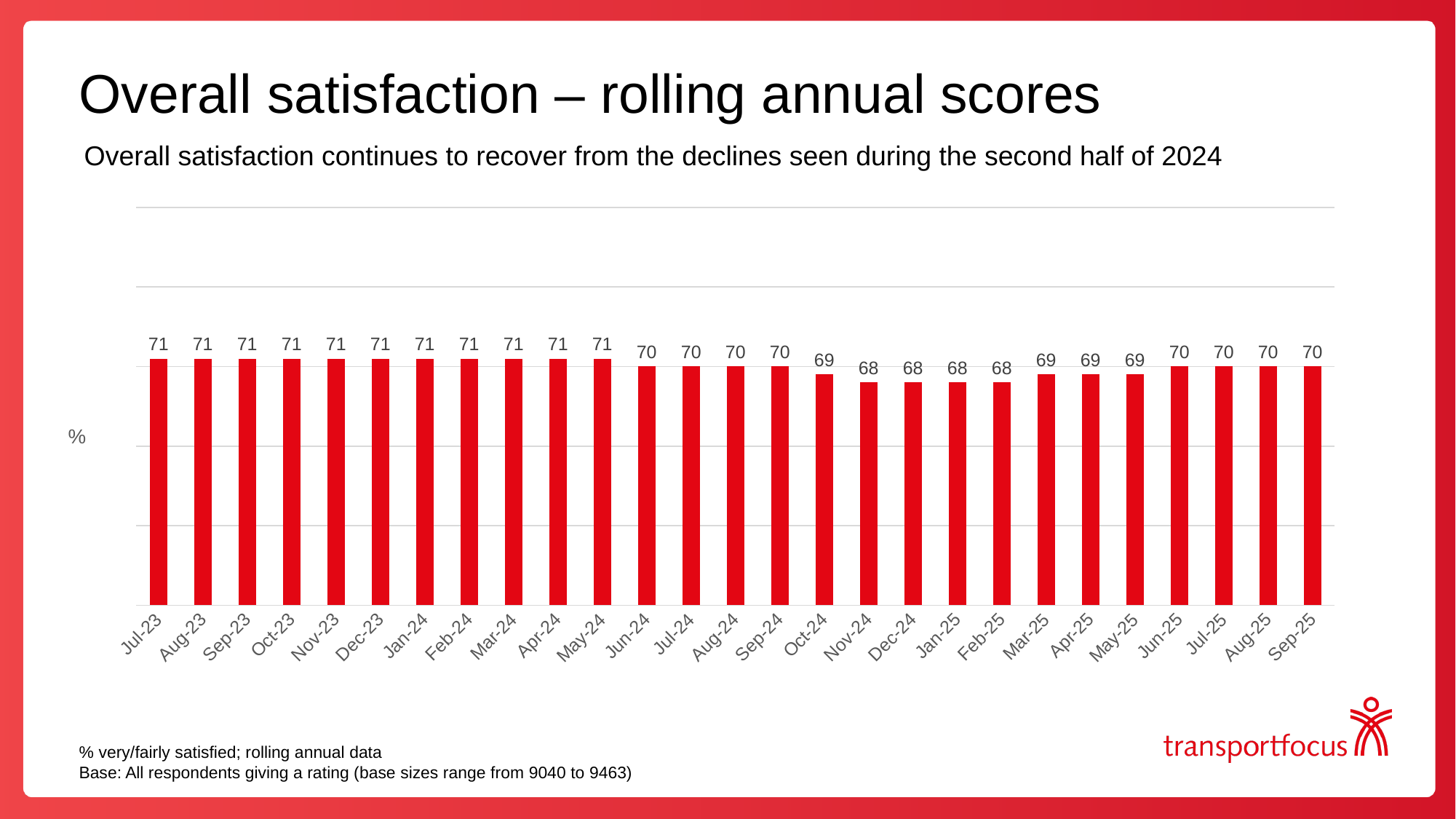
What is the overall satisfaction score for Sep-25? 70 What is the highest score shown on the chart? 71 What is the title of the slide? Overall satisfaction – rolling annual scores What is the overall satisfaction score for Jul-23? 71 What kind of chart is shown on the slide? Bar chart What is the overall satisfaction score for Oct-24? 69 What is the difference between the score for May-24 and the score for Feb-25? 3 Do the scores rise or fall from Jul-23 to Feb-25? Fall How many months are plotted on the chart? 27 Which has the larger score, Jun-24 or Jan-25? Jun-24 What is the overall satisfaction score for Dec-24? 68 What is the lowest score shown on the chart? 68